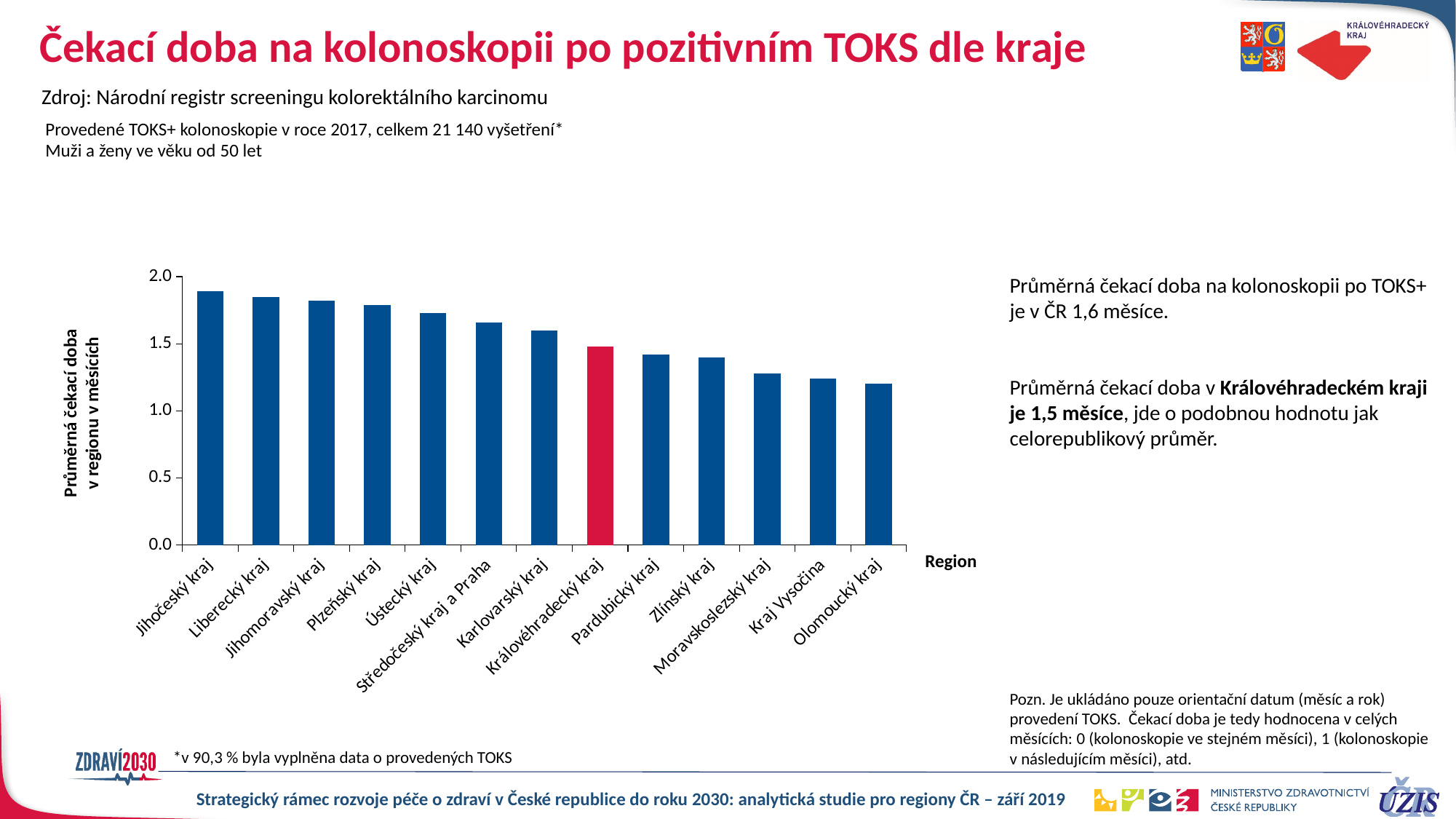
What is the label of the x axis of the chart? Region Is the value for Pardubický kraj greater or less than 1.5? less Which region has the highest average waiting time in the chart? Jihočeský kraj Which region's bar is highlighted in red in the chart? Královéhradecký kraj Is the value for Ústecký kraj greater or less than 1.5? greater What kind of chart is shown on the slide? bar chart How many regions are plotted on the x axis of the chart? 13 Is the value for Olomoucký kraj greater or less than 1.0? greater Do the bar values rise or fall from left to right along the x axis? fall Which has the larger value, Liberecký kraj or Zlínský kraj? Liberecký kraj Which region has the lowest average waiting time in the chart? Olomoucký kraj